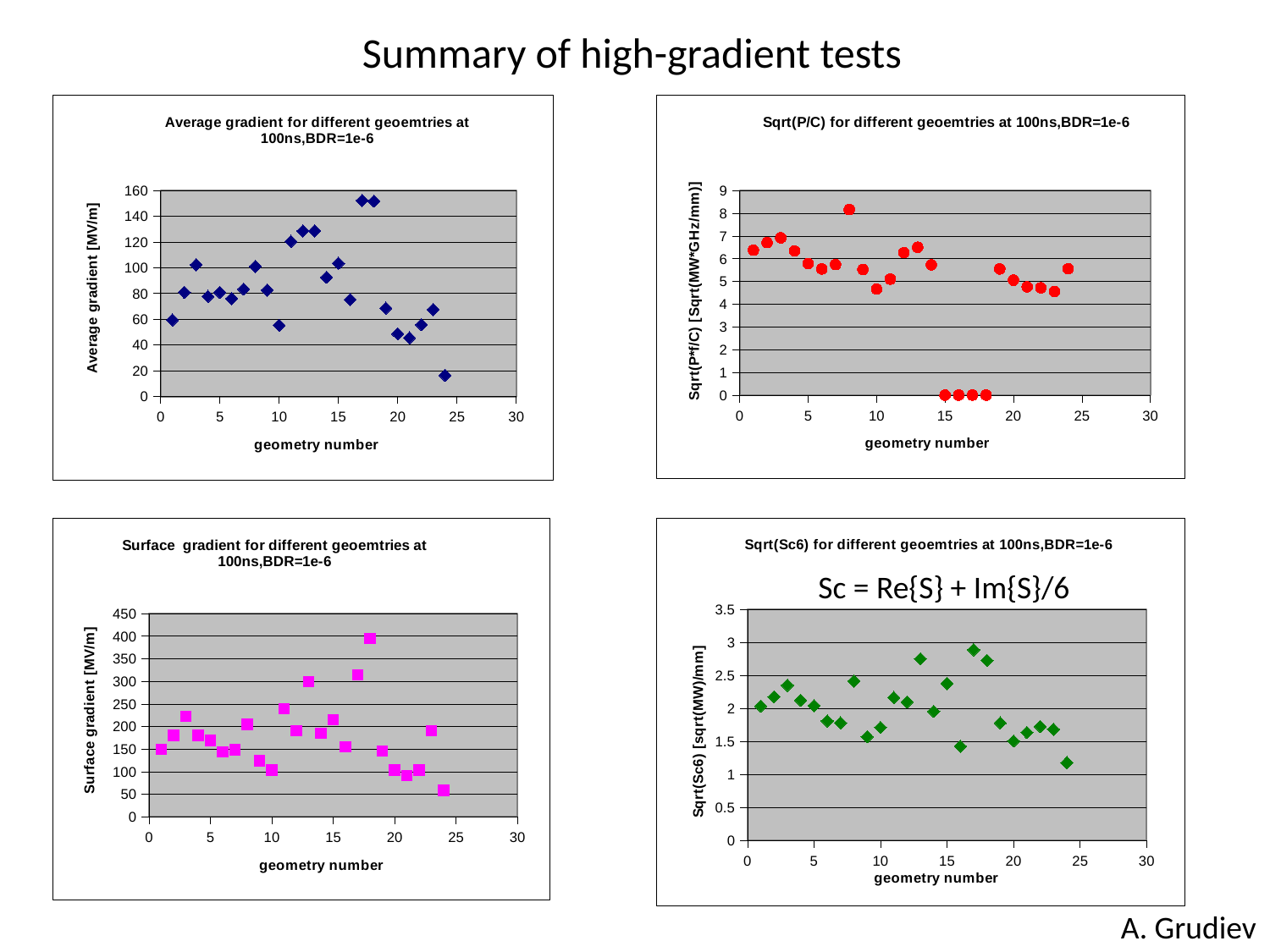
In the 'Sqrt(P/C) for different geoemtries' chart (top right), is the value for geometry number 8 greater or less than 7? greater In the 'Surface gradient for different geoemtries' chart (bottom left), what is the label of the y axis? Surface gradient [MV/m] In the 'Sqrt(Sc6) for different geoemtries' chart (bottom right), which geometry number has the highest value? 17 In the 'Average gradient for different geoemtries' chart (top left), is the value for geometry number 17 greater or less than 140? greater In the 'Surface gradient for different geoemtries' chart (bottom left), is the value for geometry number 18 greater or less than 350? greater In the 'Sqrt(P/C) for different geoemtries' chart (top right), which geometry number has the highest value? 8 In the 'Surface gradient for different geoemtries' chart (bottom left), which geometry number has the highest value? 18 How many charts are shown on the slide? 4 In the 'Average gradient for different geoemtries' chart (top left), what kind of chart is it? scatter chart In the 'Surface gradient for different geoemtries' chart (bottom left), which geometry number has the lowest value? 24